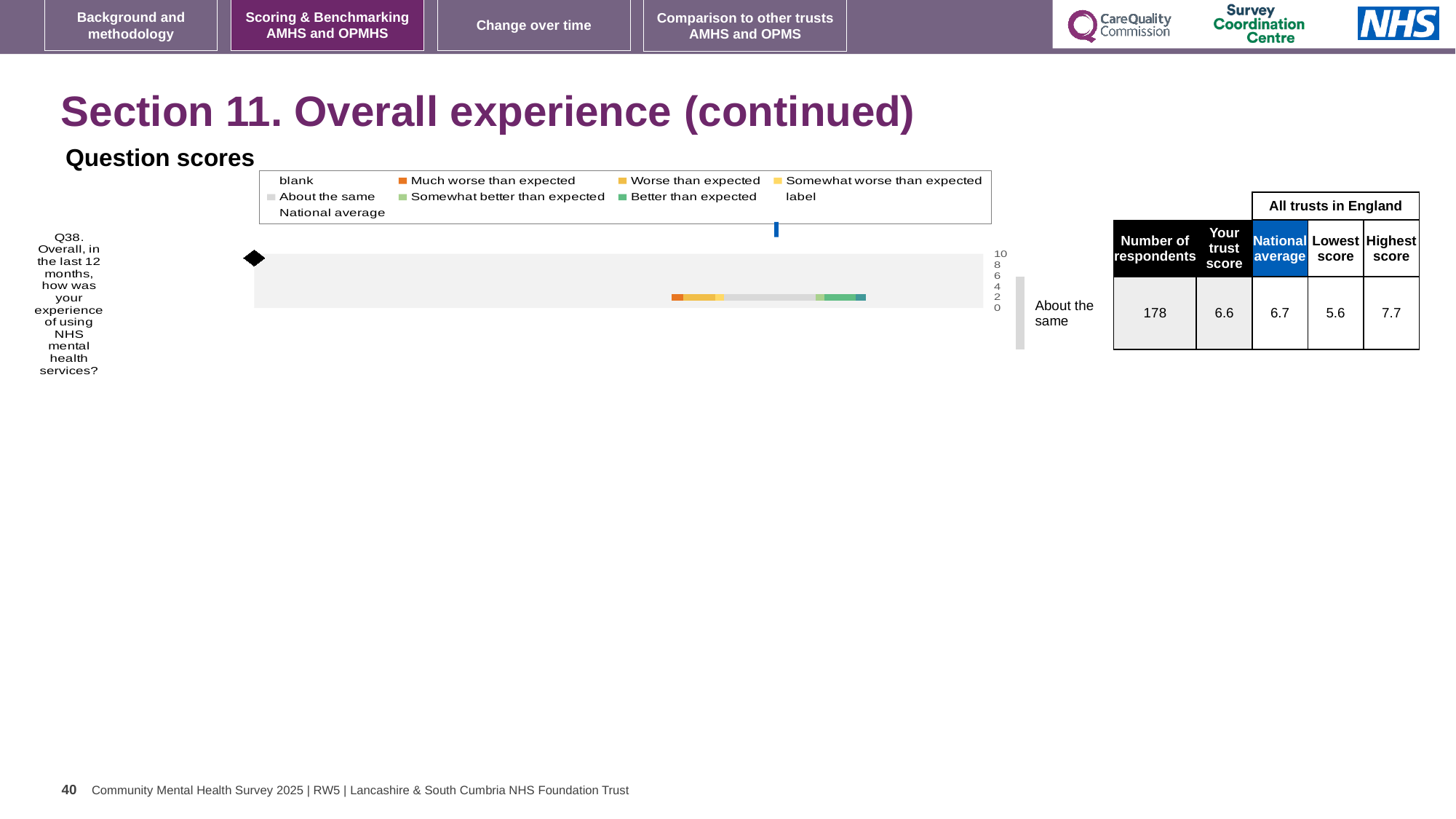
What kind of chart is shown under 'Question scores'? bar chart What is the highest tick value shown on the axis of the Question scores chart? 10 Which question is plotted in the Question scores chart? Q38. Overall, in the last 12 months, how was your experience of using NHS mental health services? In the table beside the Question scores chart, what is the national average for Q38? 6.7 How many questions (categories) are plotted in the Question scores chart? 1 What is the difference between the highest score and the lowest score for Q38 in the table beside the chart? 2.1 In the table beside the Question scores chart, what is 'Your trust score' for Q38? 6.6 In the table beside the Question scores chart, what is the lowest score among all trusts in England for Q38? 5.6 What comparison label is shown to the right of the Q38 bar in the Question scores chart? About the same In the table beside the Question scores chart, what is the number of respondents for Q38? 178 Which is larger for Q38: your trust score or the national average? national average In the table beside the Question scores chart, what is the highest score among all trusts in England for Q38? 7.7